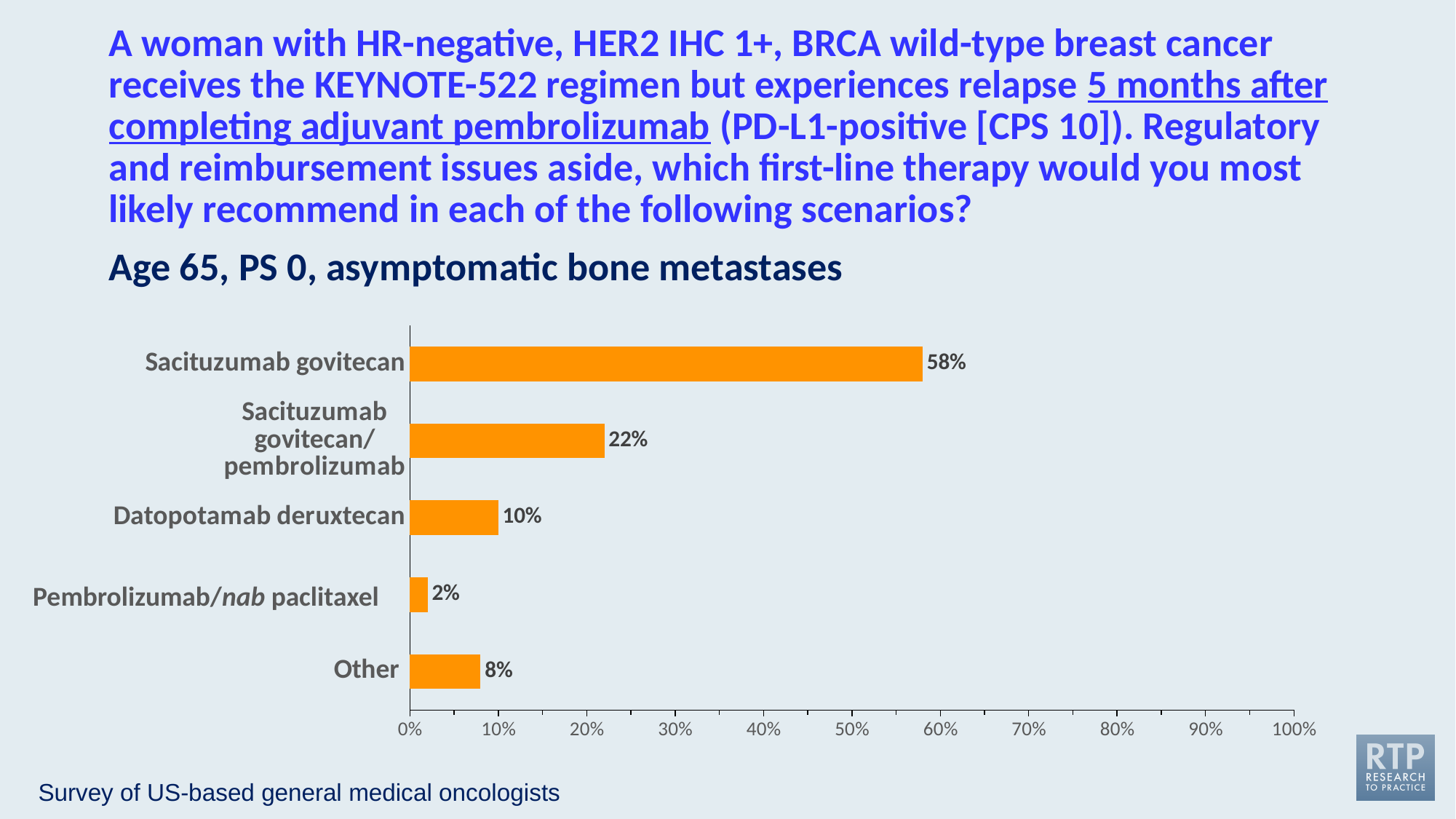
What percentage of respondents chose datopotamab deruxtecan? 10% What is the maximum value shown on the x axis? 100% Which has a larger percentage, datopotamab deruxtecan or Other? Datopotamab deruxtecan What percentage of respondents chose pembrolizumab/nab paclitaxel? 2% How many options are shown in the chart? 5 What is the difference in percentage points between sacituzumab govitecan and sacituzumab govitecan/pembrolizumab? 36 Which option has the lowest percentage? Pembrolizumab/nab paclitaxel What percentage of respondents chose sacituzumab govitecan? 58% What percentage of respondents chose Other? 8% What percentage of respondents chose sacituzumab govitecan/pembrolizumab? 22% What kind of chart is shown on the slide? Bar chart Which option has the highest percentage? Sacituzumab govitecan